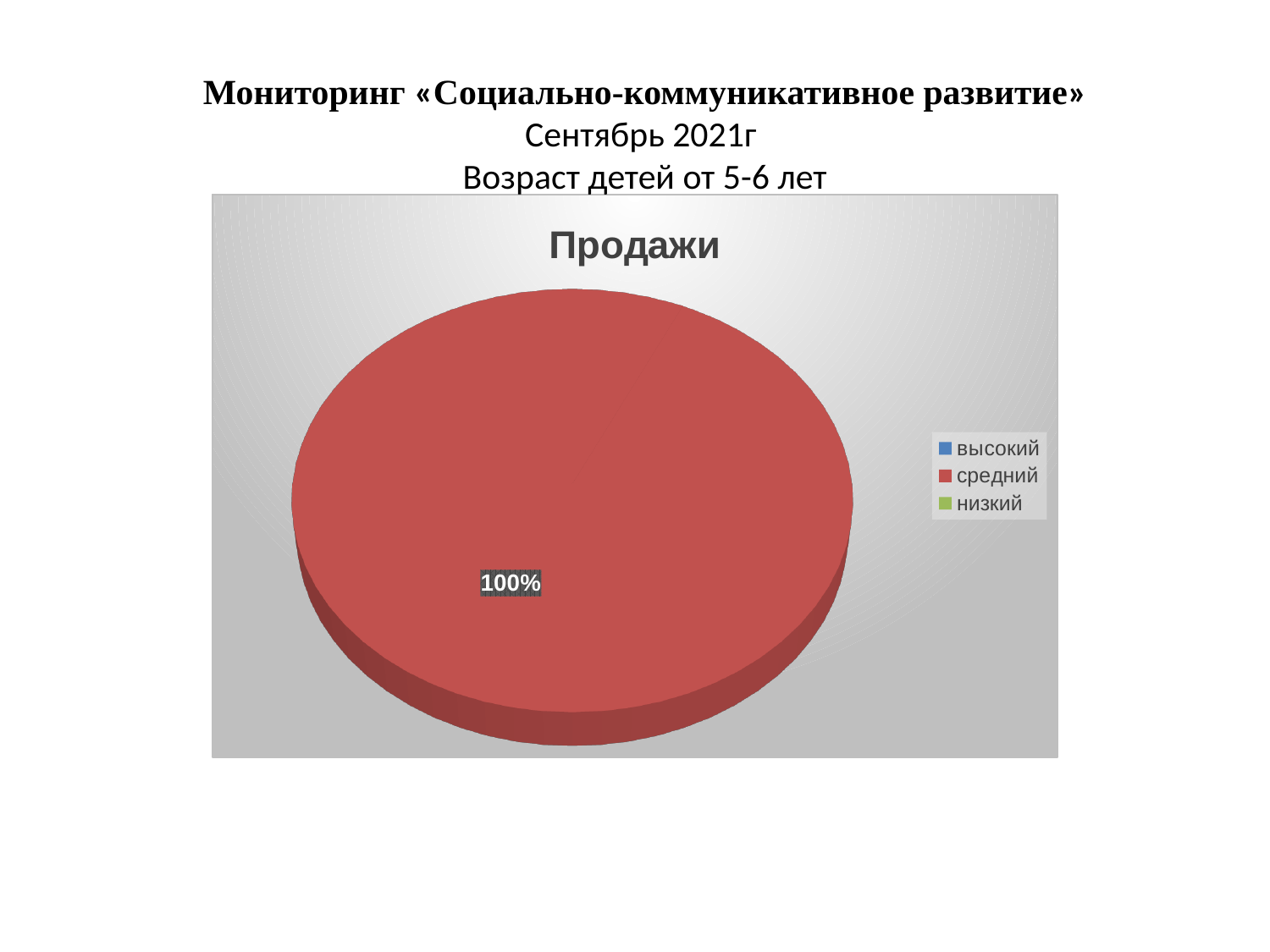
What is the title of the chart? Продажи Which is larger, the slice for 'средний' or the slice for 'высокий'? средний What kind of chart is shown on the slide? pie chart How many entries does the chart legend list? 3 Which category has the largest slice of the pie? средний What share of the pie does the 'средний' slice take? 100% What colour is the 'средний' slice in the pie chart? red What is the only percentage value printed on the pie chart? 100%